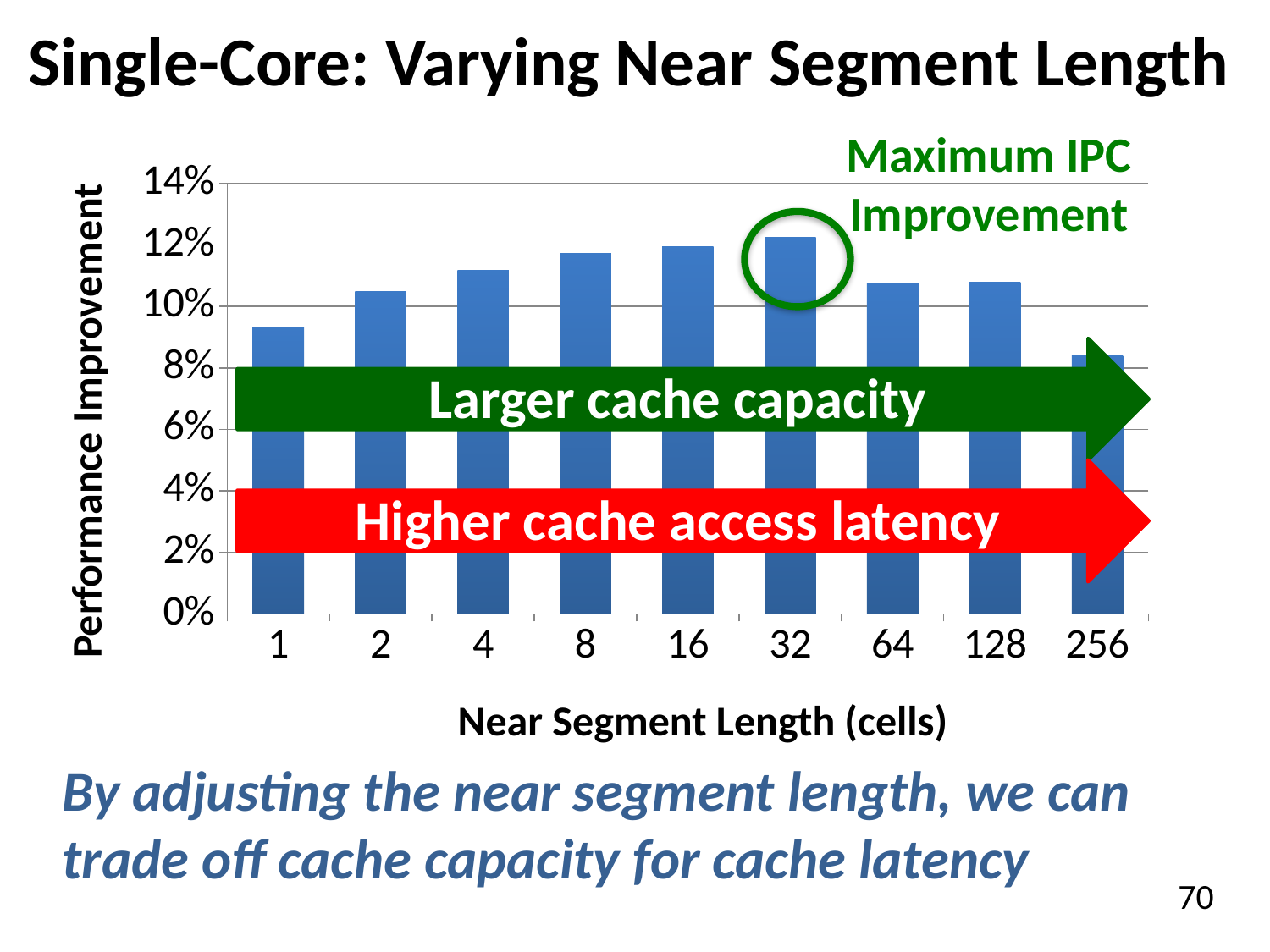
Which has the larger performance improvement, a near segment length of 32 or 1? 32 Is the performance improvement for a near segment length of 8 greater or less than 10%? greater Is the performance improvement for a near segment length of 32 greater or less than 10%? greater Is the performance improvement for a near segment length of 256 greater or less than 10%? less How many near segment lengths are plotted on the x axis? 9 What kind of chart is shown on the slide? bar chart Which has the larger performance improvement, a near segment length of 8 or 256? 8 What is the title of the x axis? Near Segment Length (cells) Which near segment length has the highest performance improvement? 32 Which near segment length has the lowest performance improvement? 256 How does performance improvement change as near segment length increases from 1 to 32? it rises